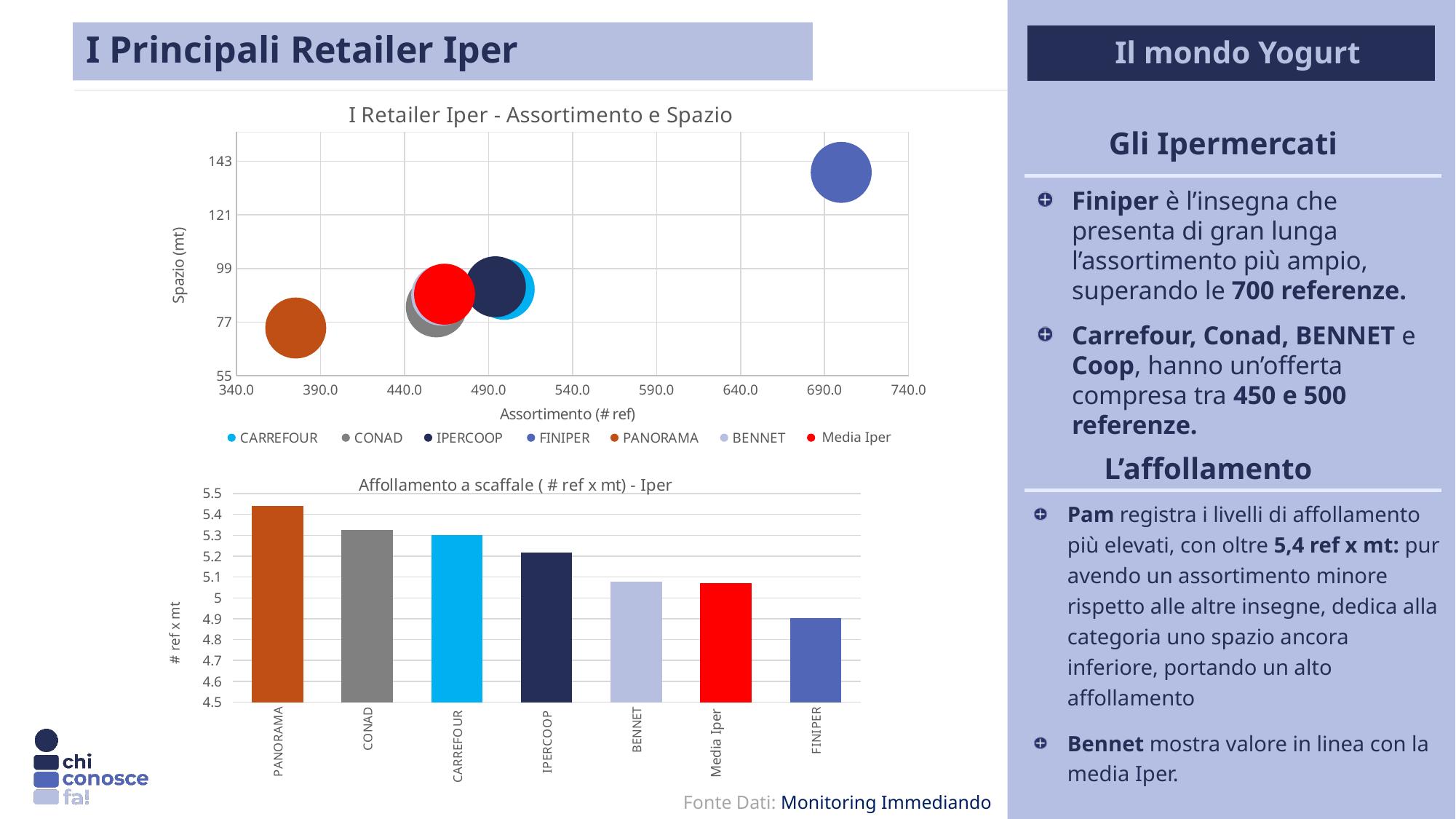
In the 'Affollamento a scaffale ( # ref x mt) - Iper' chart, is the value for FINIPER greater or less than 5? less In the 'Affollamento a scaffale ( # ref x mt) - Iper' chart, which is larger, the value for PANORAMA or the value for FINIPER? PANORAMA How many bars are shown in the 'Affollamento a scaffale ( # ref x mt) - Iper' chart? 7 In the 'Affollamento a scaffale ( # ref x mt) - Iper' chart, do the values rise or fall from left to right? fall How many series does the legend of the 'I Retailer Iper - Assortimento e Spazio' chart list? 7 What kind of chart is the 'Affollamento a scaffale ( # ref x mt) - Iper' chart? bar chart In the 'Affollamento a scaffale ( # ref x mt) - Iper' chart, which retailer has the lowest value? FINIPER What is the label of the y axis in the 'I Retailer Iper - Assortimento e Spazio' chart? Spazio (mt) In the 'Affollamento a scaffale ( # ref x mt) - Iper' chart, is the value for PANORAMA greater or less than 5.4? greater In the 'Affollamento a scaffale ( # ref x mt) - Iper' chart, which retailer has the highest value? PANORAMA In the 'I Retailer Iper - Assortimento e Spazio' chart, is the Assortimento (# ref) value for FINIPER greater or less than 640.0? greater